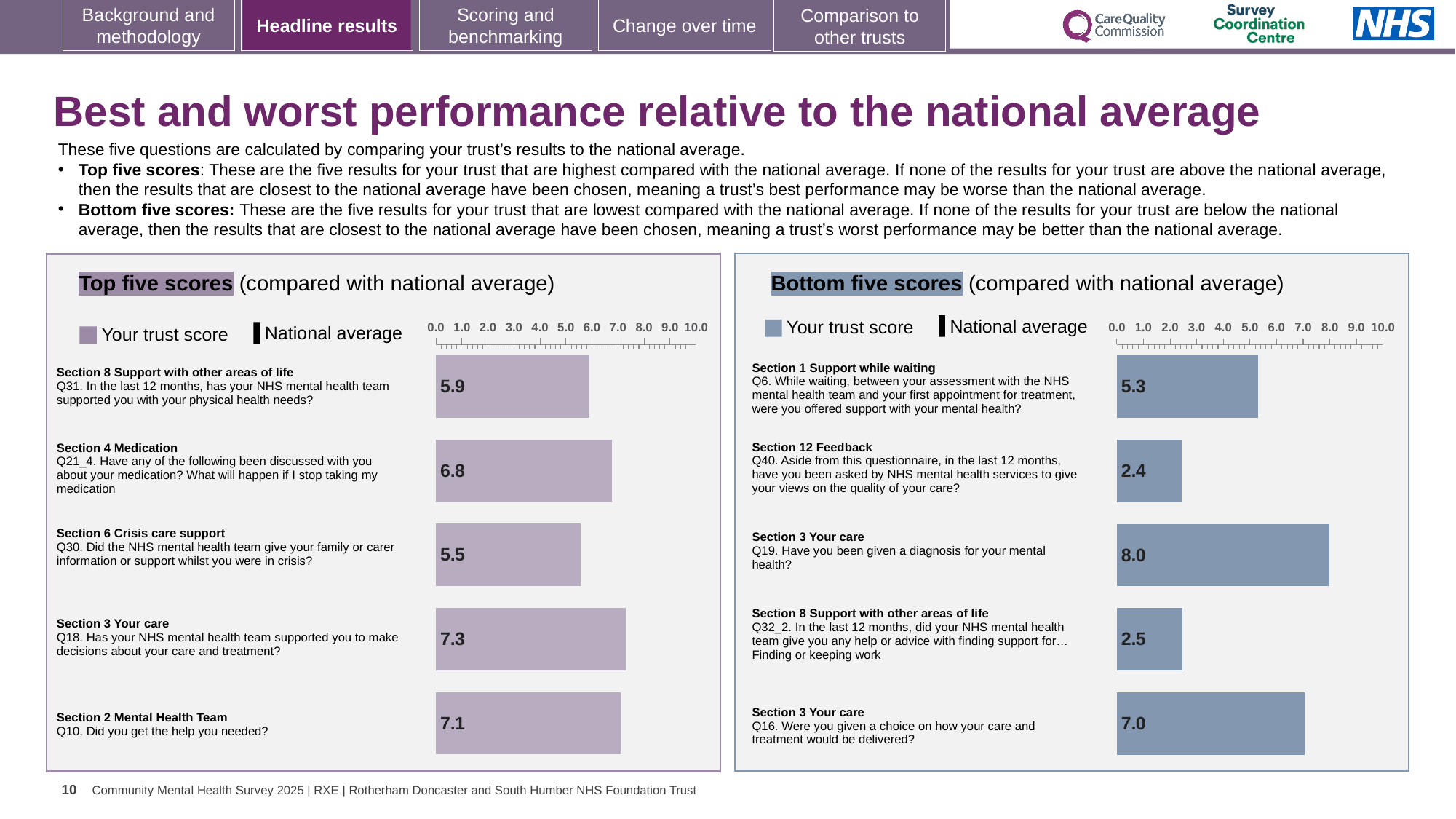
In the Top five scores chart, what is the difference between the trust scores for Q21_4 and Q31? 0.9 In the Top five scores chart, which question has the highest trust score? Q18 In the Top five scores chart, is the trust score for Q10 greater or less than 6.0? greater In the Bottom five scores chart, which question has the highest trust score? Q19 How many series does the legend of the Top five scores chart list? 2 In the Top five scores chart, which question has the lowest trust score? Q30 What type of chart is the Top five scores chart? Bar chart In the Bottom five scores chart, what is the difference between the trust scores for Q19 and Q16? 1.0 In the Top five scores chart, what is the trust score for Q18 (Has your NHS mental health team supported you to make decisions about your care and treatment?)? 7.3 How many questions are shown in the Bottom five scores chart? 5 In the Bottom five scores chart, what is the trust score for Q40 (have you been asked by NHS mental health services to give your views on the quality of your care?)? 2.4 In the Bottom five scores chart, which has the larger trust score, Q6 or Q16? Q16